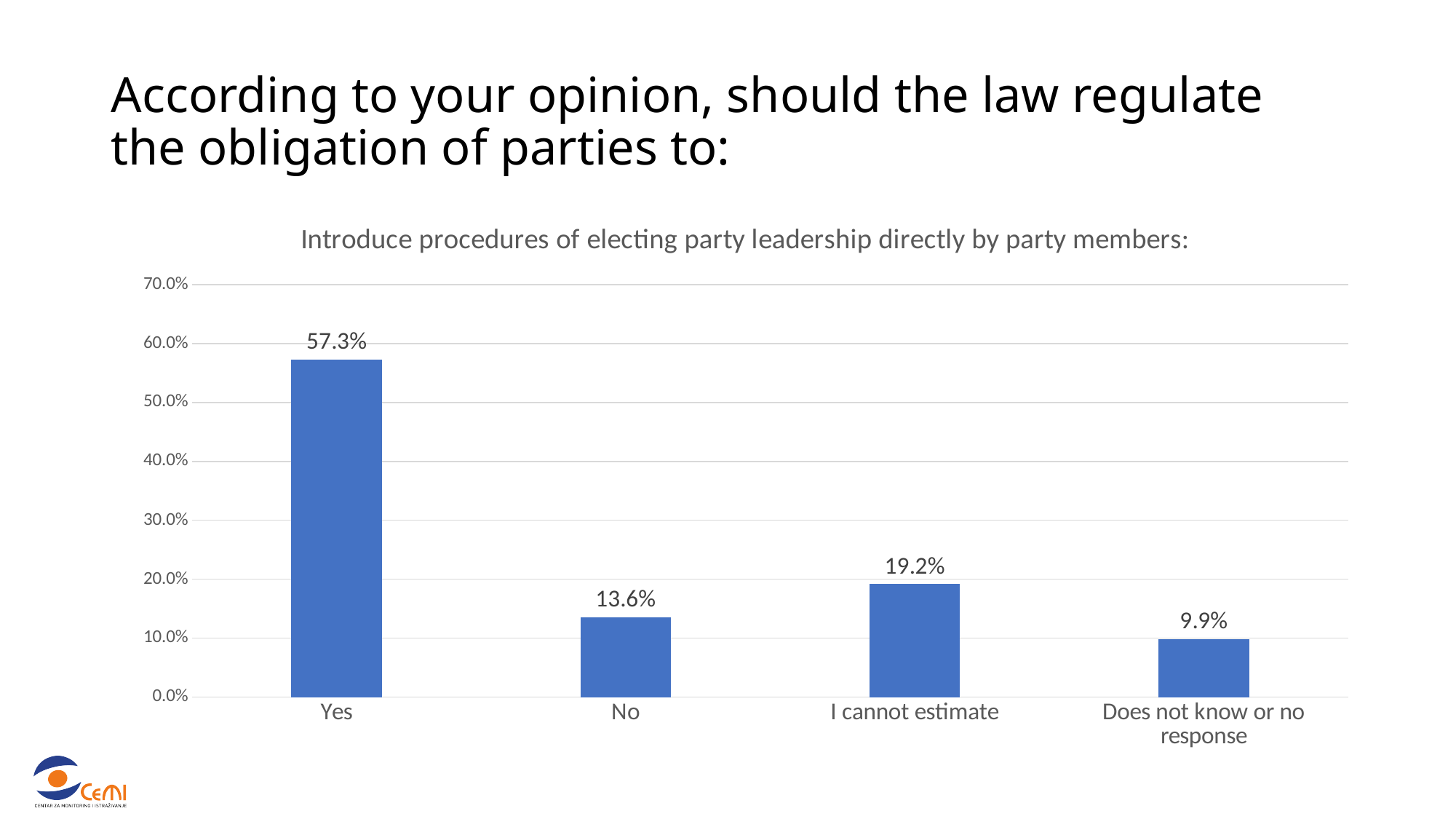
What is the value for "Does not know or no response"? 9.9% How many categories are shown on the x axis? 4 Which category has the highest value? Yes What is the value for "Yes"? 57.3% What is the title of the chart? Introduce procedures of electing party leadership directly by party members: What is the value for "I cannot estimate"? 19.2% Which is larger, the value for "No" or the value for "I cannot estimate"? I cannot estimate What is the value for "No"? 13.6% Which category has the lowest value? Does not know or no response What is the difference between the values for "Yes" and "No"? 43.7% What kind of chart is shown on the slide? Bar chart Is the value for "Yes" greater or less than 50.0%? greater